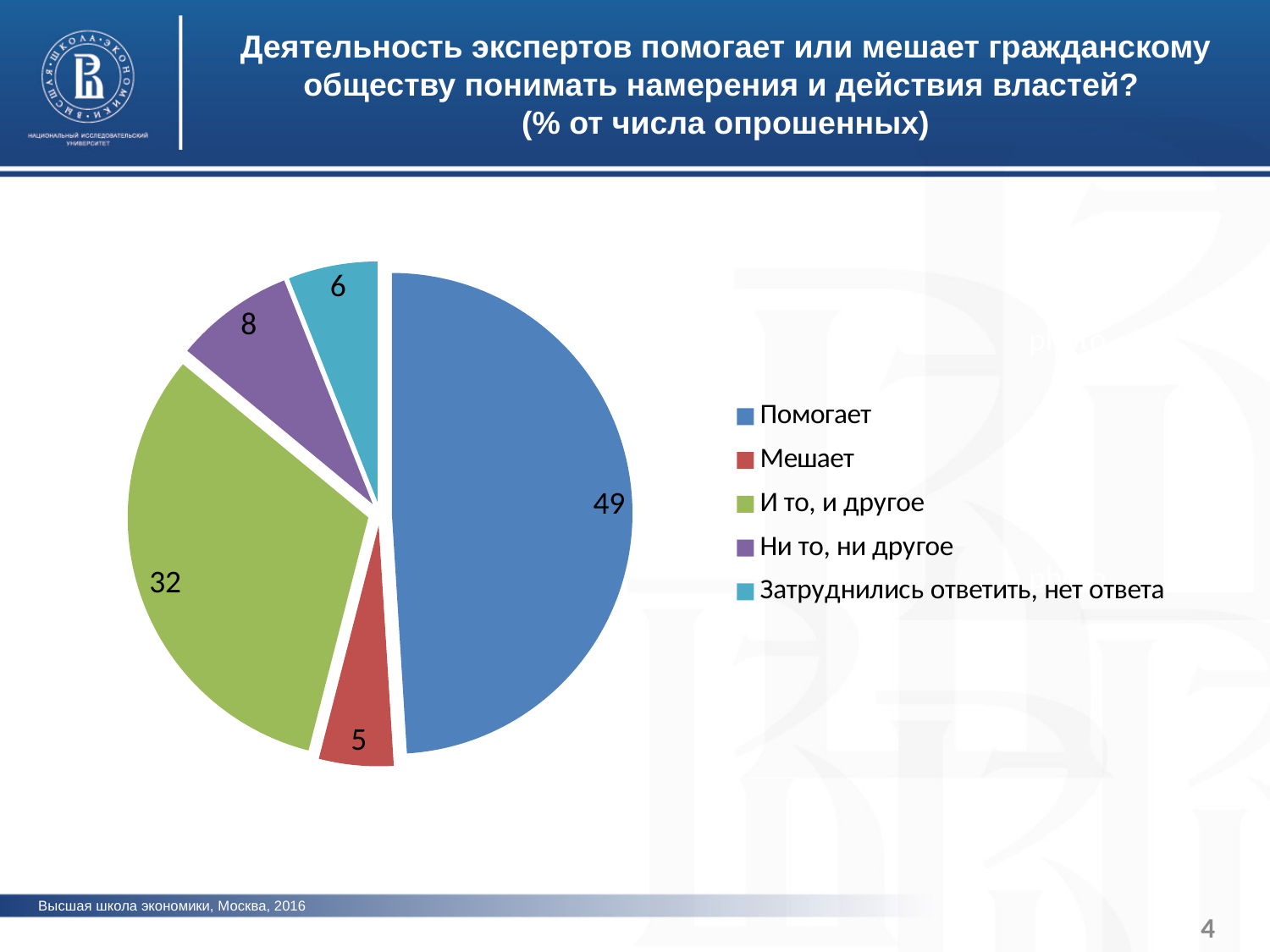
What share of the pie does "И то, и другое" represent? 32% What is the value for "Мешает"? 5 Which category has the largest slice of the pie? Помогает Which category has the smallest slice of the pie? Мешает How many slices does the pie chart have? 5 Which colour is used for the "Мешает" slice? red What is the value for "Затруднились ответить, нет ответа"? 6 What kind of chart is shown on the slide? pie chart Which is larger, the value for "Ни то, ни другое" or the value for "Затруднились ответить, нет ответа"? Ни то, ни другое What is the value for "И то, и другое"? 32 What is the difference between the values for "Помогает" and "И то, и другое"? 17 What is the value for "Помогает"? 49